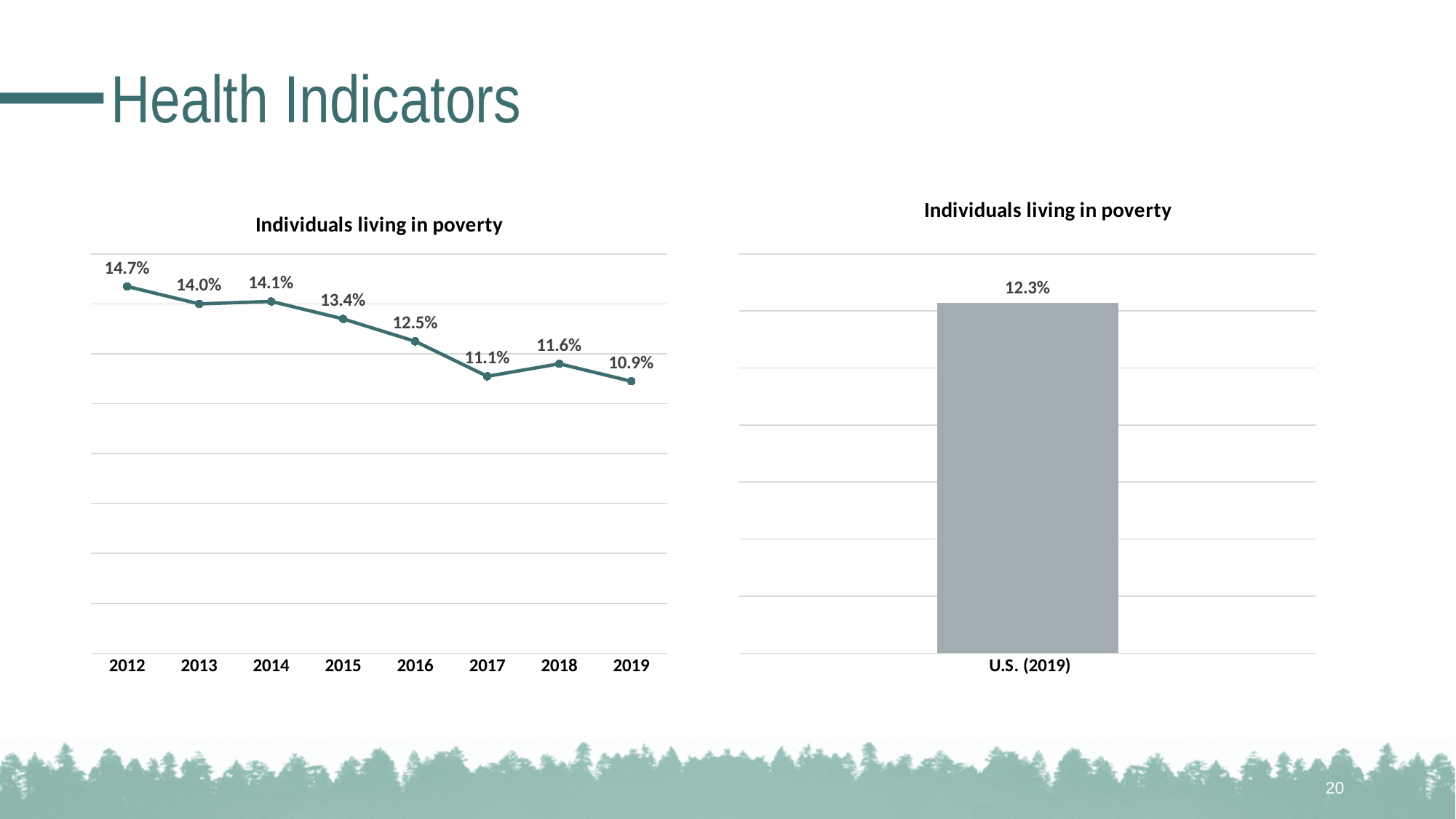
What is the title of the chart on the left side of the slide? Individuals living in poverty In the right bar chart, what is the value for U.S. (2019)? 12.3% In the left line chart, do the values generally rise or fall from 2012 to 2019? fall How many data points are plotted in the left line chart? 8 In the left line chart, which is larger, the value for 2017 or the value for 2018? 2018 In the left line chart, which year has the lowest value? 2019 In the left line chart, what is the value for 2019? 10.9% In the left line chart, which year has the highest value? 2012 What kind of chart is the chart on the right side of the slide? bar chart In the left line chart, what is the difference between the 2012 value and the 2019 value? 3.8% In the left line chart, what is the value for 2016? 12.5% In the left line chart, what is the value for 2012? 14.7%